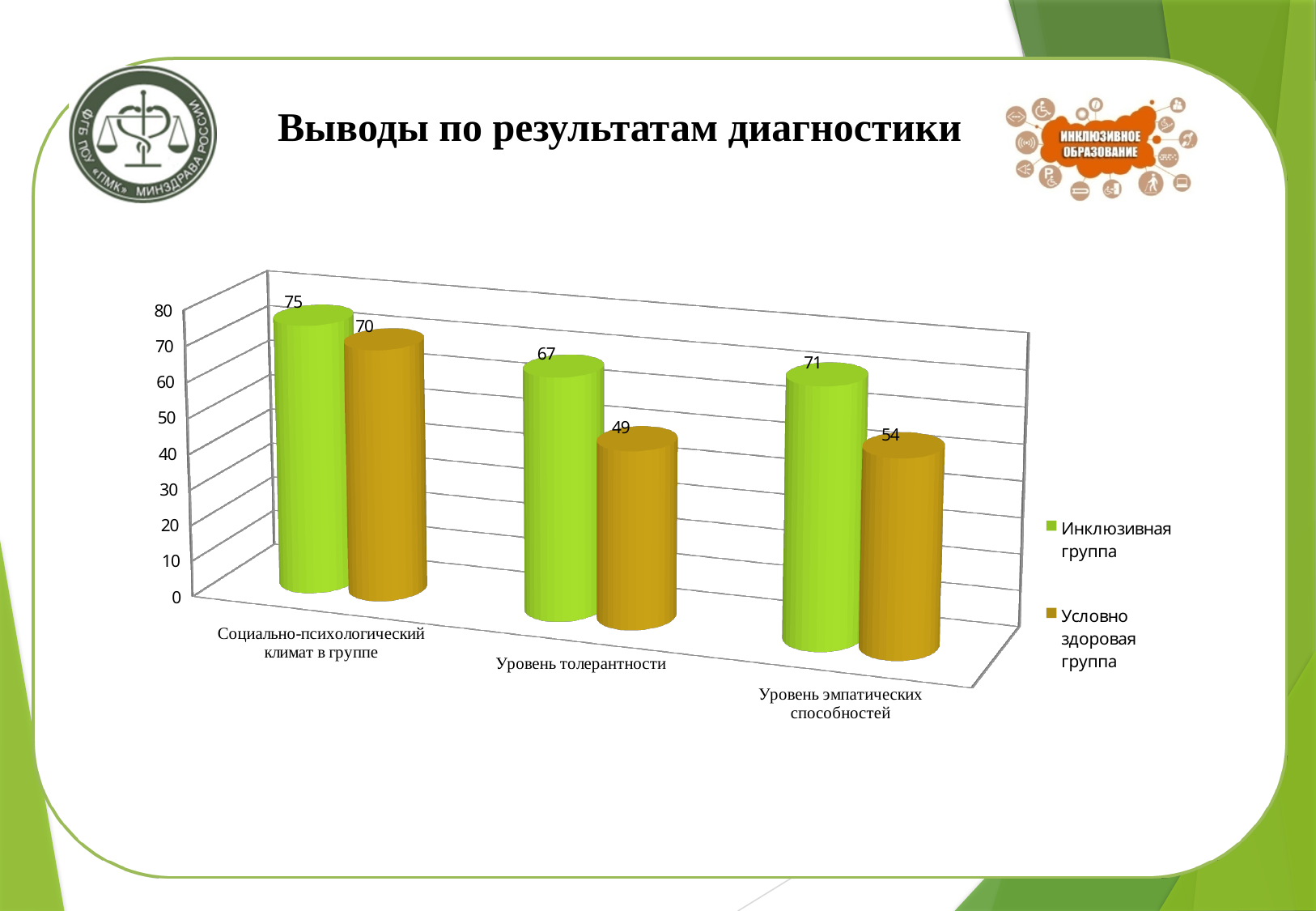
What is the value for the Условно здоровая группа series in the Уровень эмпатических способностей category? 54 Which category has the lowest value for the Условно здоровая группа series? Уровень толерантности What is the value for the Условно здоровая группа series in the Уровень толерантности category? 49 What kind of chart is shown on the slide? Bar chart How many categories are shown on the x axis? 3 What is the value for the Инклюзивная группа series in the Уровень эмпатических способностей category? 71 How many series does the legend list? 2 Which series has the larger value in the Уровень эмпатических способностей category? Инклюзивная группа What is the value for the Инклюзивная группа series in the Социально-психологический климат в группе category? 75 Which category has the highest value for the Инклюзивная группа series? Социально-психологический климат в группе What is the title of the slide containing the chart? Выводы по результатам диагностики What is the difference between the Инклюзивная группа and Условно здоровая группа values in the Уровень толерантности category? 18